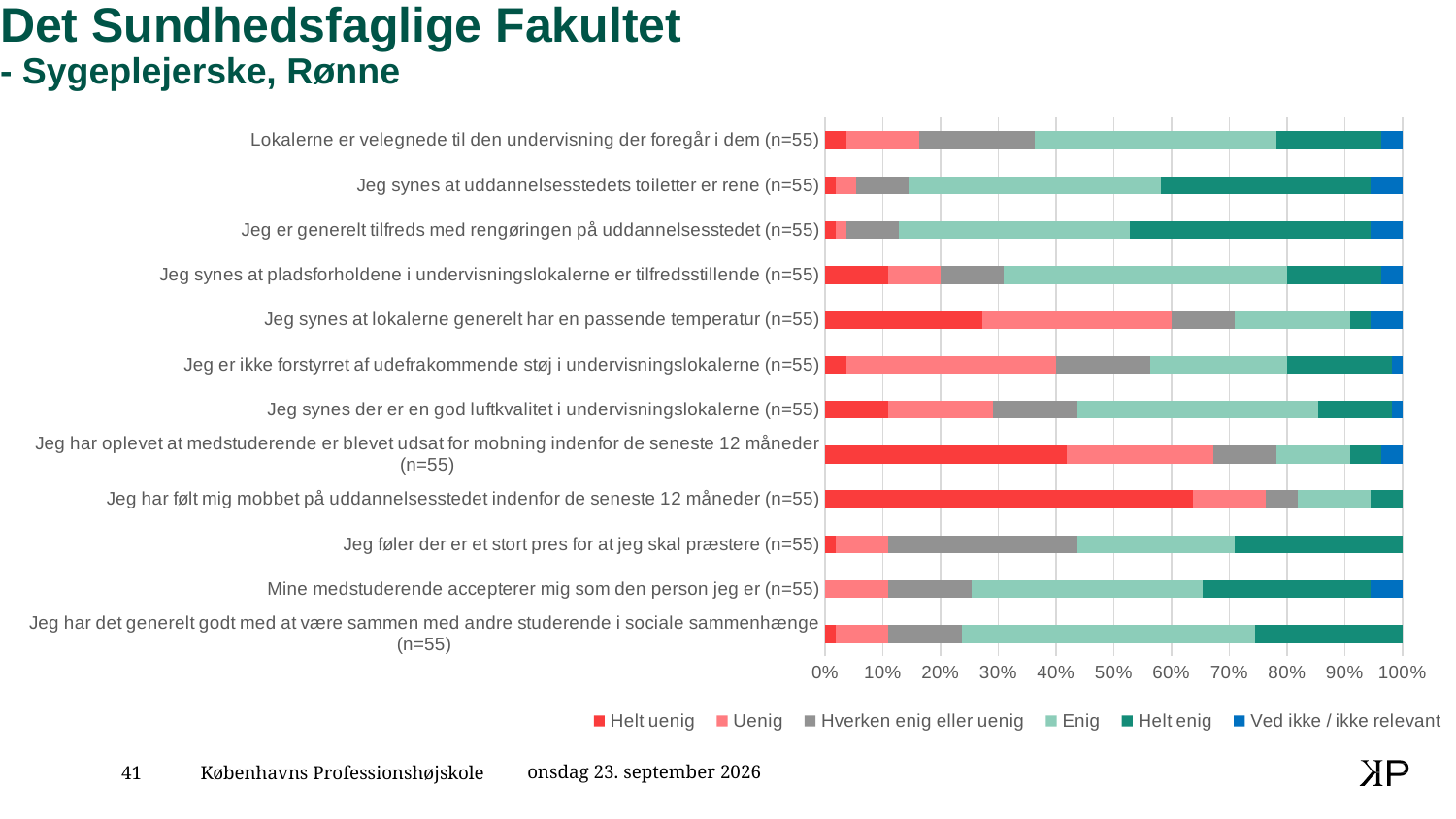
Is the 'Helt uenig' share for 'Jeg synes at lokalerne generelt har en passende temperatur' greater or less than 20%? greater What do the segments of each stacked bar add up to? 100% What kind of chart is shown on the slide? Stacked bar chart Which statement has the largest 'Helt uenig' segment? Jeg har følt mig mobbet på uddannelsesstedet indenfor de seneste 12 måneder (n=55) Is the 'Helt uenig' share for 'Jeg har oplevet at medstuderende er blevet udsat for mobning indenfor de seneste 12 måneder' greater or less than 30%? greater Which has the larger 'Helt uenig' share: 'Jeg har følt mig mobbet på uddannelsesstedet indenfor de seneste 12 måneder' or 'Jeg synes at lokalerne generelt har en passende temperatur'? Jeg har følt mig mobbet på uddannelsesstedet indenfor de seneste 12 måneder What is the sample size (n) shown for each statement in the chart? n=55 Is the 'Helt uenig' share for 'Jeg føler der er et stort pres for at jeg skal præstere' greater or less than 10%? less How many series does the legend list? 6 How many statements (categories) are plotted in the chart? 12 Which legend entry is shown in blue? Ved ikke / ikke relevant